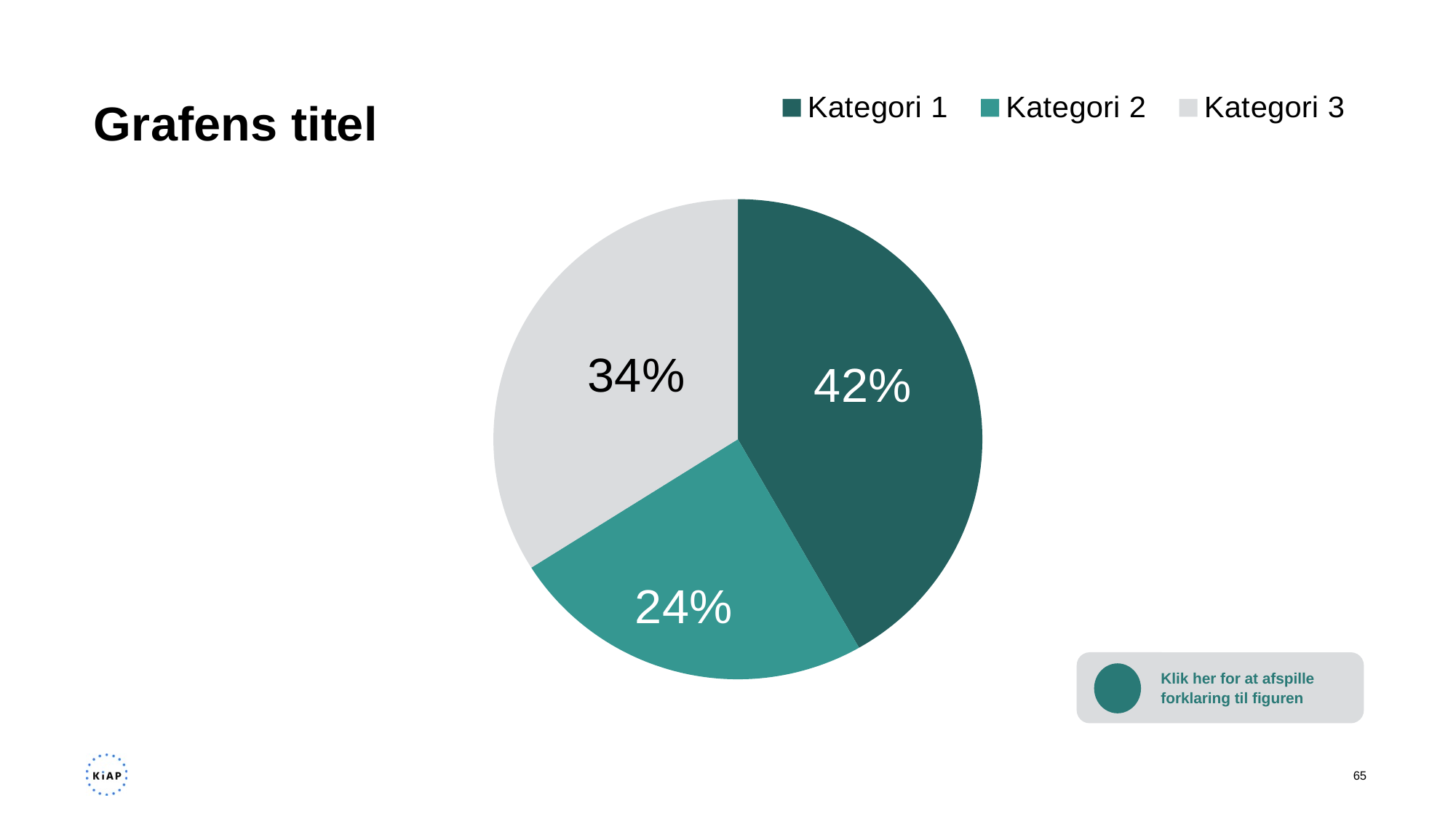
What share of the pie does Kategori 1 have? 42% Which category has the largest slice of the pie? Kategori 1 What kind of chart is shown on the slide? pie chart What share of the pie does Kategori 3 have? 34% What is the difference in percentage points between Kategori 3 and Kategori 2? 10 How many slices does the pie chart have? 3 Which is larger, the slice for Kategori 3 or the slice for Kategori 2? Kategori 3 What is the difference in percentage points between Kategori 1 and Kategori 2? 18 Which category has the smallest slice of the pie? Kategori 2 How many entries does the legend list? 3 What is the title of the chart? Grafens titel What share of the pie does Kategori 2 have? 24%